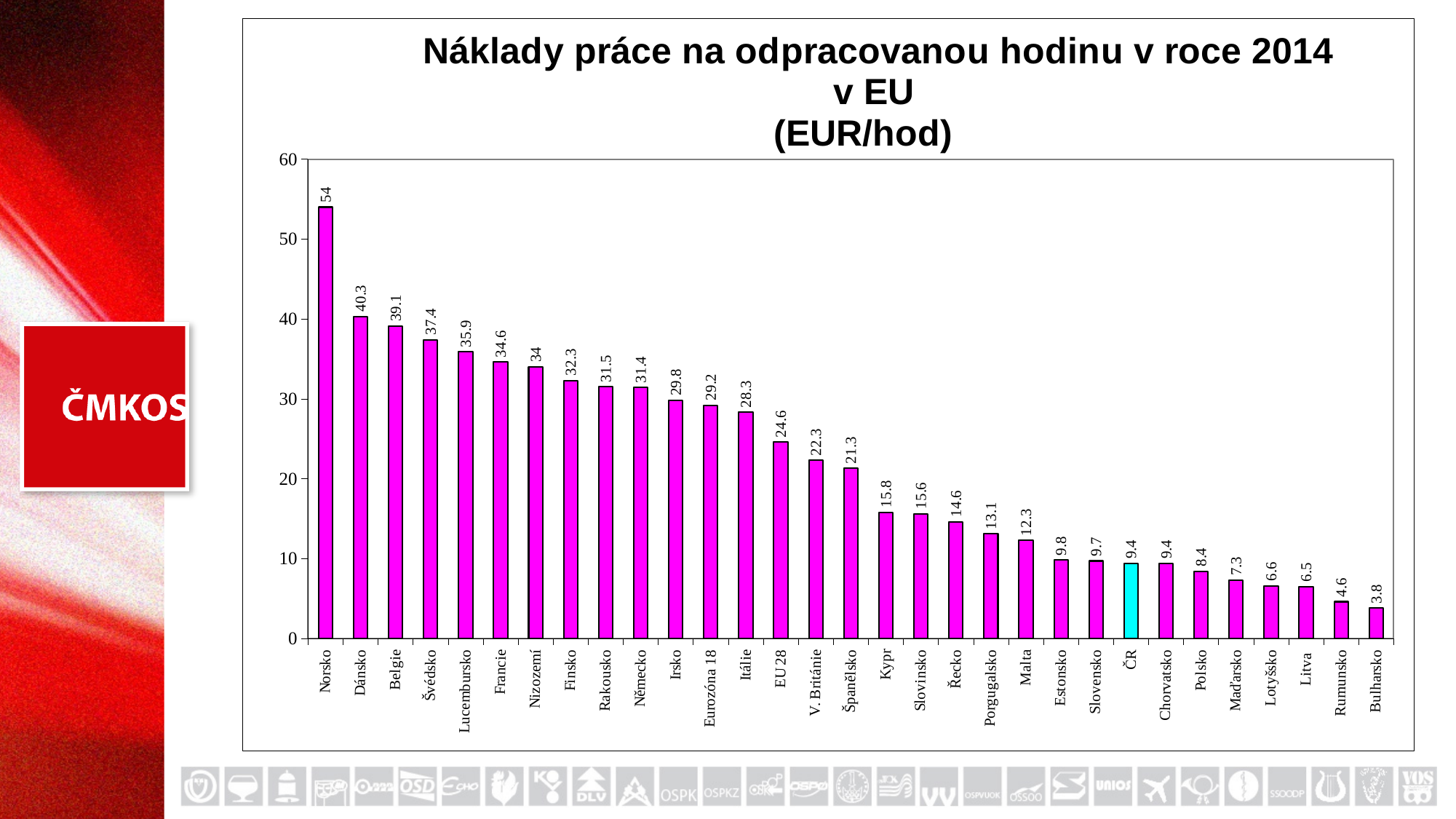
Which country has the lowest labour cost per hour? Bulharsko What is the difference between the values for EU 28 and ČR? 15.2 Which bar is highlighted in a different colour (cyan) from the others? ČR Which is larger, the value for Dánsko or the value for Belgie? Dánsko What is the value for Německo? 31.4 Which country has the highest labour cost per hour? Norsko Is the value for Francie greater or less than 30? greater What is the difference between the values for Norsko and Bulharsko? 50.2 How many categories are shown on the x axis? 31 What kind of chart is shown on the slide? bar chart What is the value for EU 28? 24.6 What is the value for ČR? 9.4